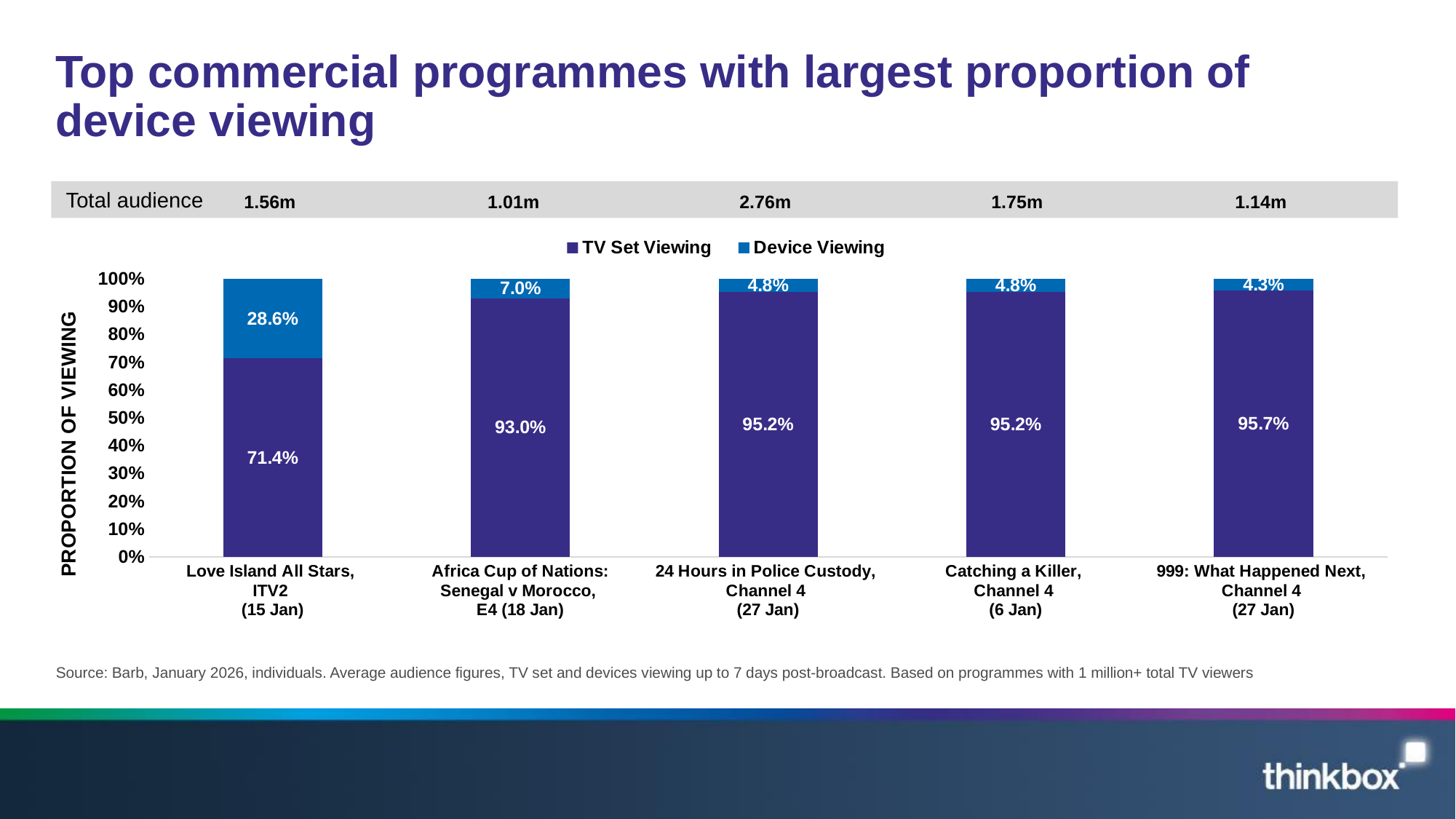
What is the label of the y axis? PROPORTION OF VIEWING What kind of chart is shown on the slide? Stacked bar chart Which is larger: the TV Set Viewing share for Catching a Killer or for Love Island All Stars? Catching a Killer Which programme has the highest Device Viewing share? Love Island All Stars, ITV2 (15 Jan) Which programme has the lowest Device Viewing share? 999: What Happened Next, Channel 4 (27 Jan) What is the total audience shown for 24 Hours in Police Custody, Channel 4 (27 Jan)? 2.76m What is the difference between the Device Viewing share for Love Island All Stars and for Africa Cup of Nations: Senegal v Morocco? 21.6% What is the TV Set Viewing share for Africa Cup of Nations: Senegal v Morocco, E4 (18 Jan)? 93.0% How many series does the legend list? 2 What is the Device Viewing share for 999: What Happened Next, Channel 4 (27 Jan)? 4.3% What is the Device Viewing share for Love Island All Stars, ITV2 (15 Jan)? 28.6% How many programmes are shown on the chart? 5